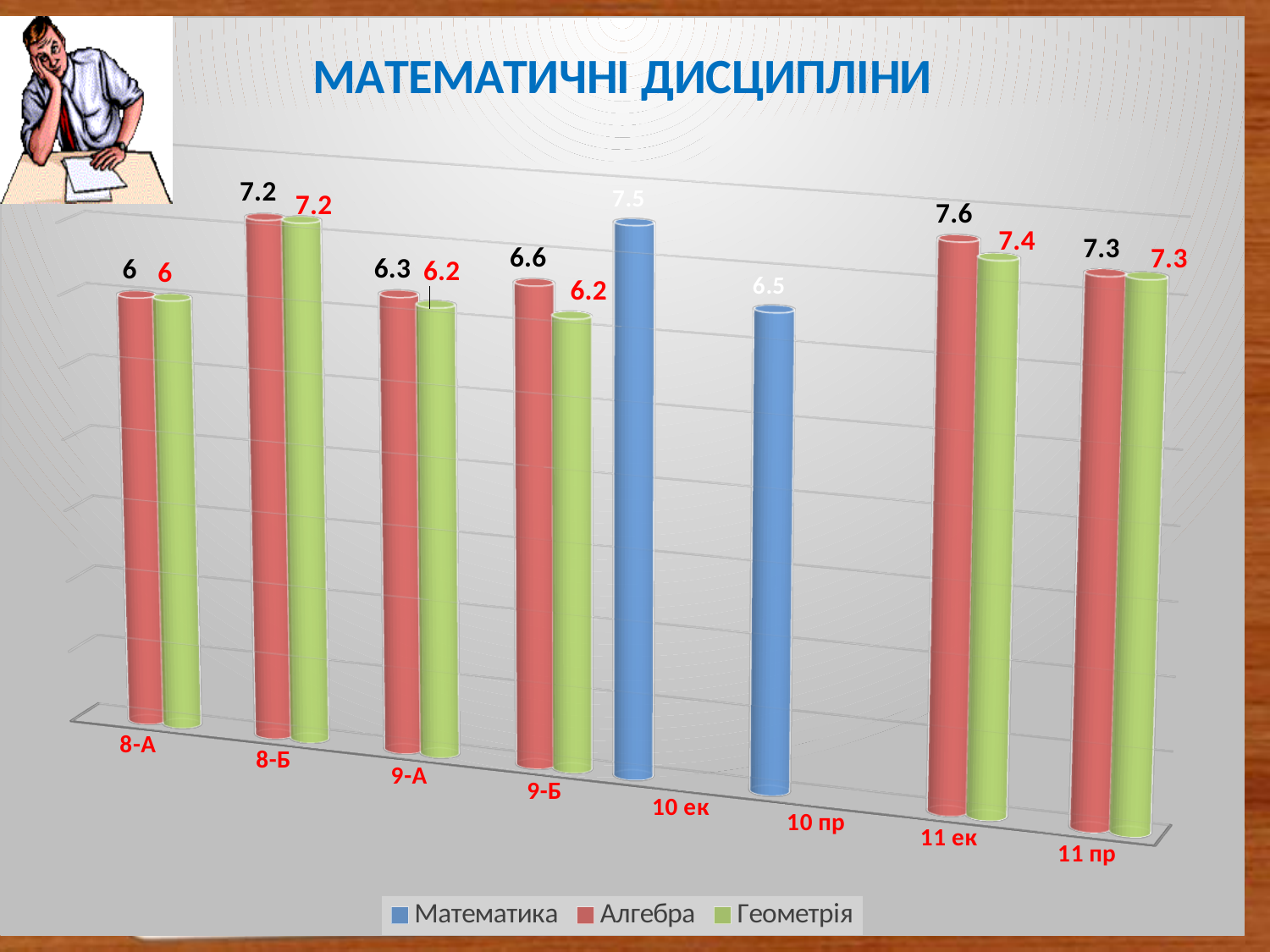
What is the difference between the Алгебра and Геометрія values for 9-Б? 0.4 What is the Математика value for 10 пр? 6.5 How many categories are shown on the x axis? 8 What is the Геометрія value for 9-Б? 6.2 How many series does the legend list? 3 Which is larger, the Математика value for 10 ек or for 10 пр? 10 ек What is the Алгебра value for 8-Б? 7.2 What is the Математика value for 10 ек? 7.5 Which category has the lowest Алгебра value? 8-А What kind of chart is shown on the slide? Bar chart What is the Геометрія value for 11 ек? 7.4 Which category has the highest Алгебра value? 11 ек